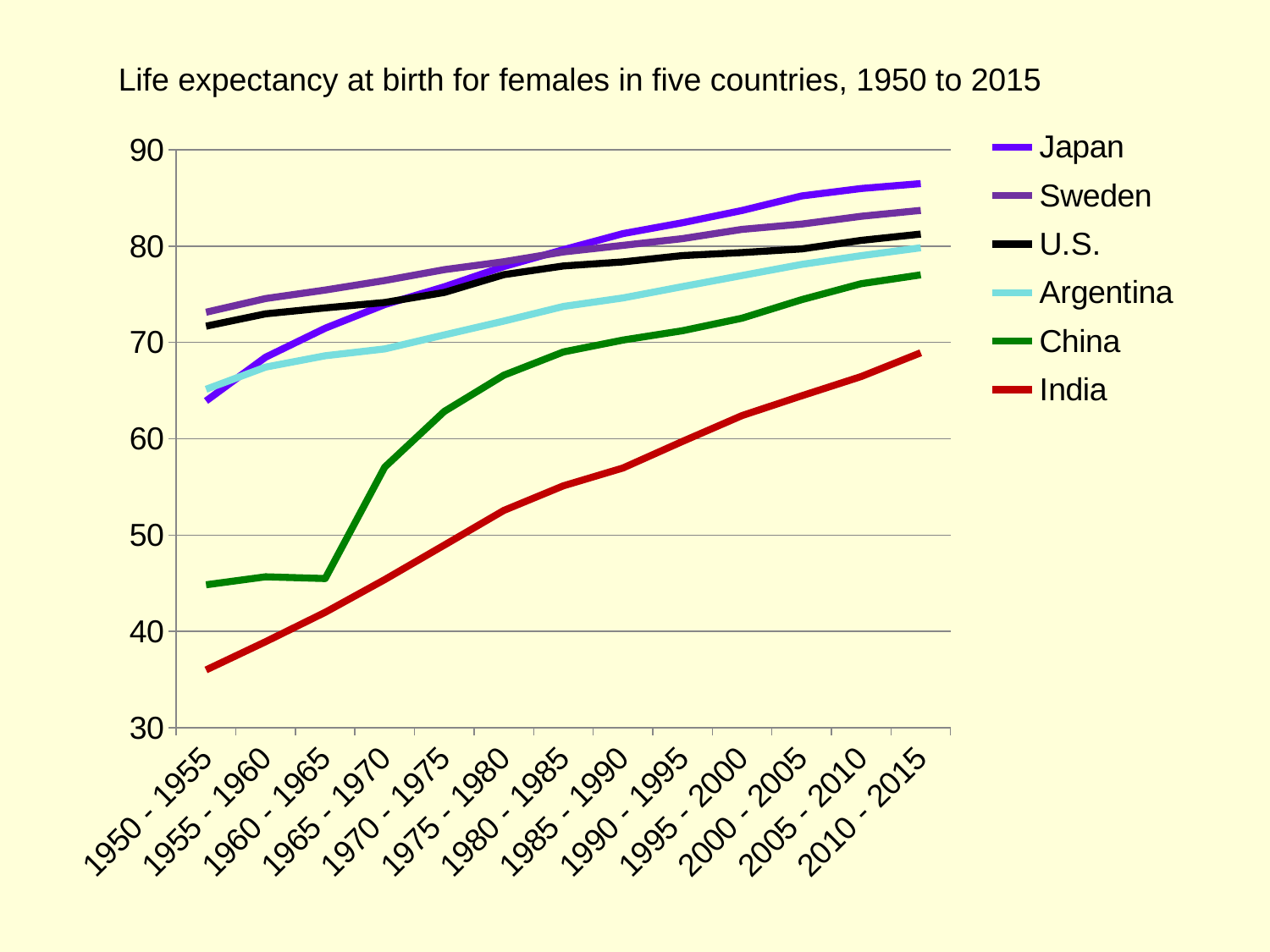
Which country has the lowest female life expectancy in the 2010 - 2015 period? India How many series does the legend list? 6 Is the value for China in 1950 - 1955 greater or less than 50? less Which is larger in 1950 - 1955, the value for Japan or the value for Sweden? Sweden What kind of chart is shown on the slide? line chart What is the title of the chart? Life expectancy at birth for females in five countries, 1950 to 2015 Is the value for India in 1950 - 1955 greater or less than 40? less Which country has the lowest female life expectancy in the 1950 - 1955 period? India Is the value for Japan in 2010 - 2015 greater or less than 80? greater How many time periods are shown along the x axis? 13 Which country has the highest female life expectancy in the 2010 - 2015 period? Japan Does the line for India rise or fall from 1950 - 1955 to 2010 - 2015? rise